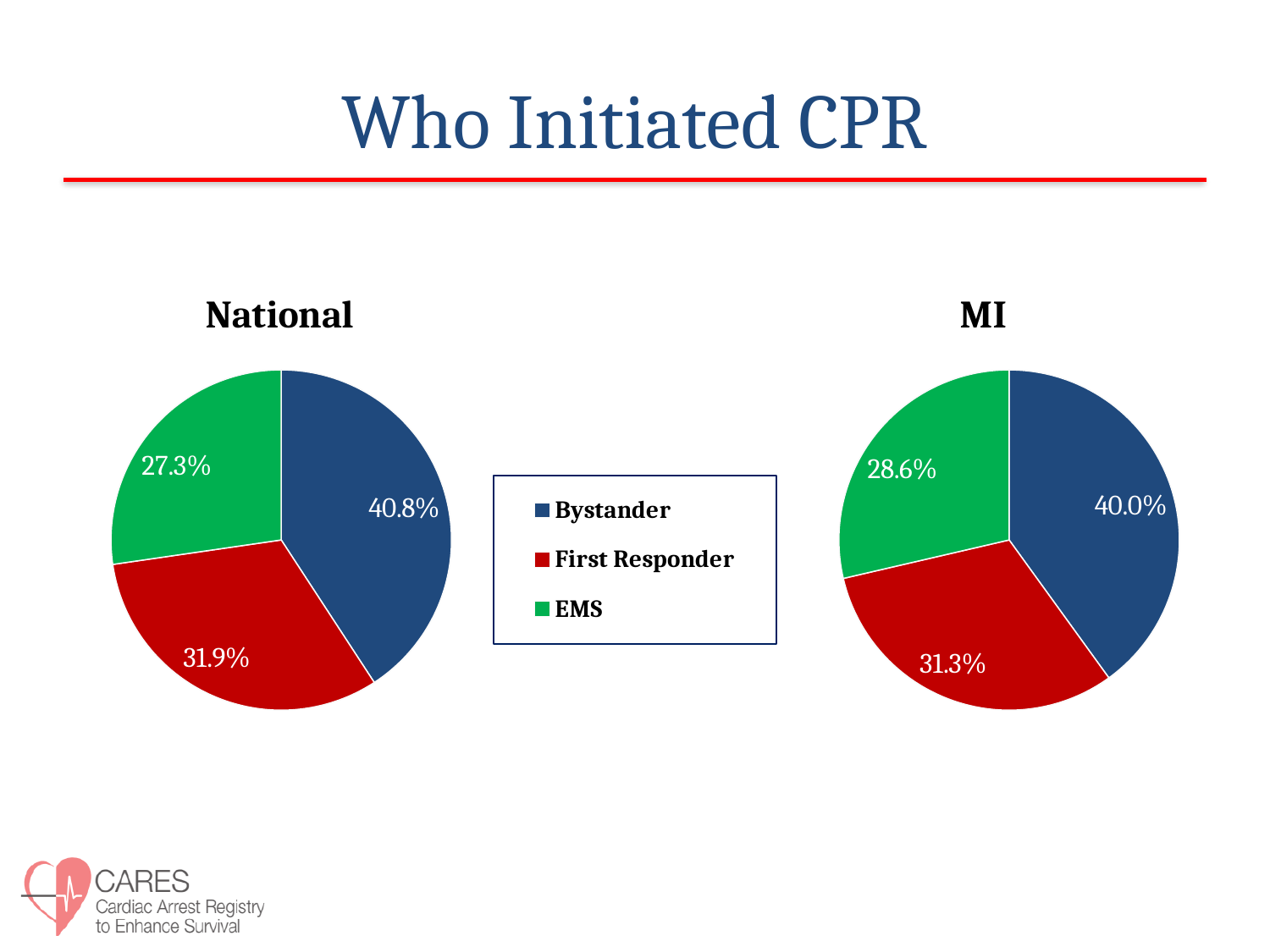
In the National pie chart, which category has the largest share? Bystander In the National pie chart, what is the difference between the Bystander and EMS shares? 13.5% In the MI pie chart, which category has the smallest share? EMS Which colour represents First Responder in the legend? Red In the MI pie chart, what is the value for First Responder? 31.3% In the MI pie chart, is the EMS share greater or less than the First Responder share? less Is the Bystander share larger in the National chart or the MI chart? National In the National pie chart, what share of CPR was initiated by Bystanders? 40.8% What type of chart is used on this slide? Pie chart How many categories does each pie chart show? 3 In the National pie chart, what is the value for First Responder? 31.9% In the MI pie chart, what share of CPR was initiated by EMS? 28.6%